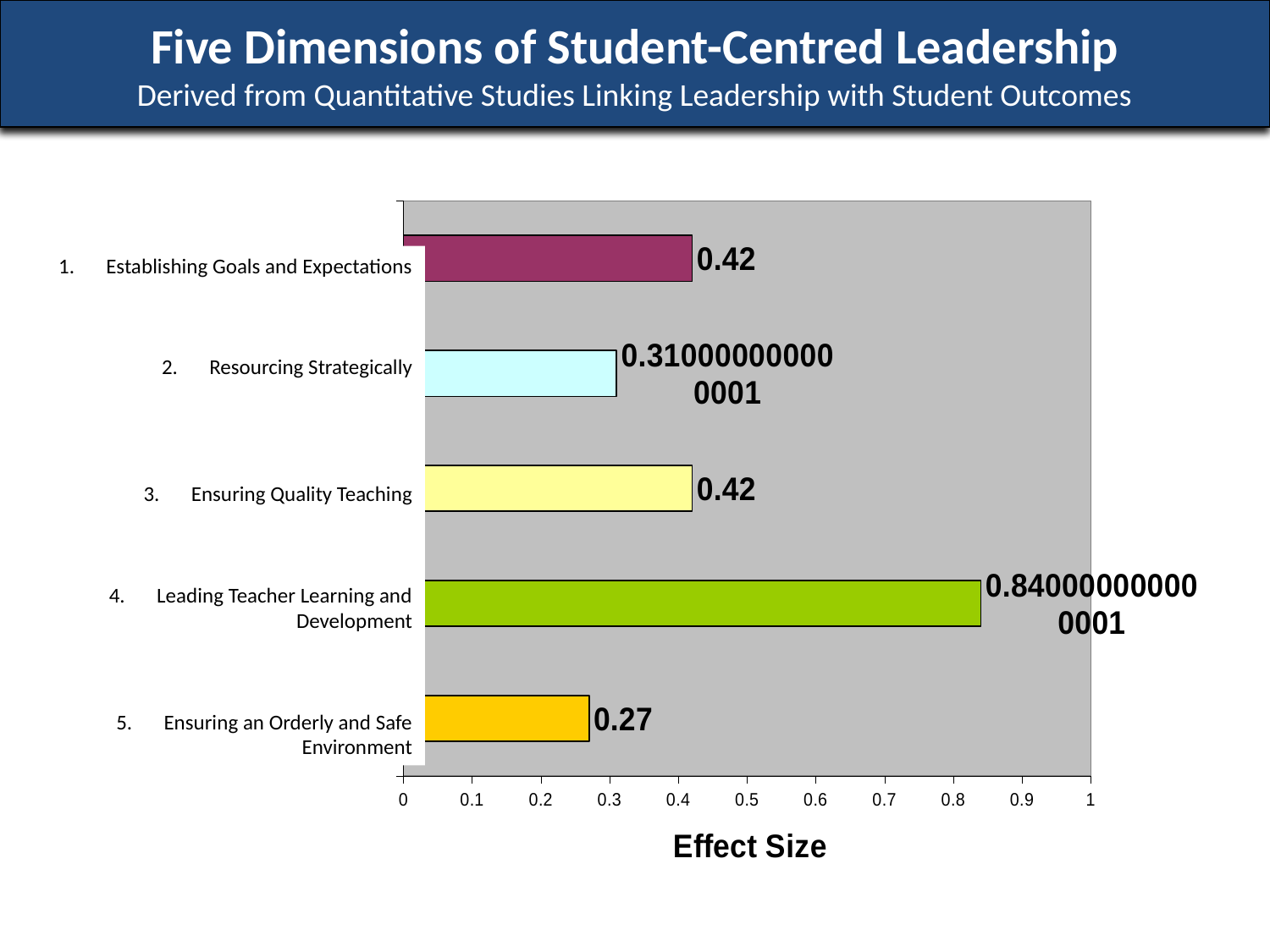
What is the effect size for Ensuring an Orderly and Safe Environment? 0.27 Which dimension has the smallest effect size? Ensuring an Orderly and Safe Environment What is the effect size for Establishing Goals and Expectations? 0.42 Which has a larger effect size, Resourcing Strategically or Ensuring Quality Teaching? Ensuring Quality Teaching What is the effect size for Ensuring Quality Teaching? 0.42 Which dimension has the largest effect size? Leading Teacher Learning and Development What is the title of the horizontal axis? Effect Size What kind of chart is shown on the slide? Bar chart How many dimensions are plotted in the chart? 5 Is the effect size for Resourcing Strategically greater or less than 0.4? less What is the difference between the effect size for Establishing Goals and Expectations and the effect size for Ensuring an Orderly and Safe Environment? 0.15 Is the effect size for Leading Teacher Learning and Development greater or less than 0.8? greater